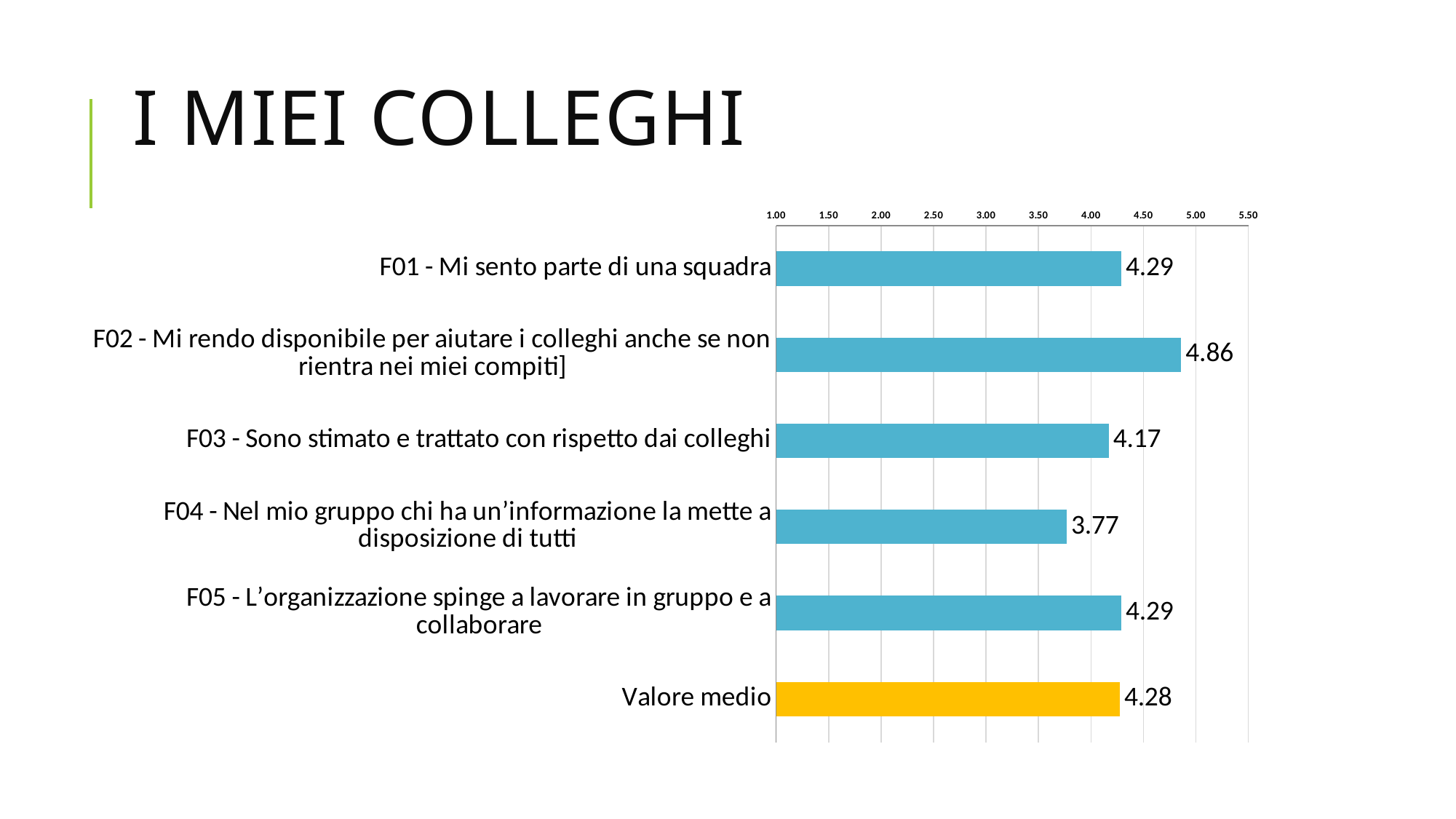
Which is larger, the value for F03 or the value for F05? F05 Which category has the highest value? F02 - Mi rendo disponibile per aiutare i colleghi anche se non rientra nei miei compiti Is the value for F04 greater or less than 4.00? less How many bars are shown in the chart? 6 What is the value for F04 - Nel mio gruppo chi ha un'informazione la mette a disposizione di tutti? 3.77 What is the value for F02 - Mi rendo disponibile per aiutare i colleghi anche se non rientra nei miei compiti? 4.86 Which category has the lowest value? F04 - Nel mio gruppo chi ha un'informazione la mette a disposizione di tutti What is the difference between the value for F03 and the Valore medio? 0.11 What is the difference between the values for F02 and F04? 1.09 What is the value for F01 - Mi sento parte di una squadra? 4.29 What is the value shown for Valore medio? 4.28 What kind of chart is shown on the slide? bar chart